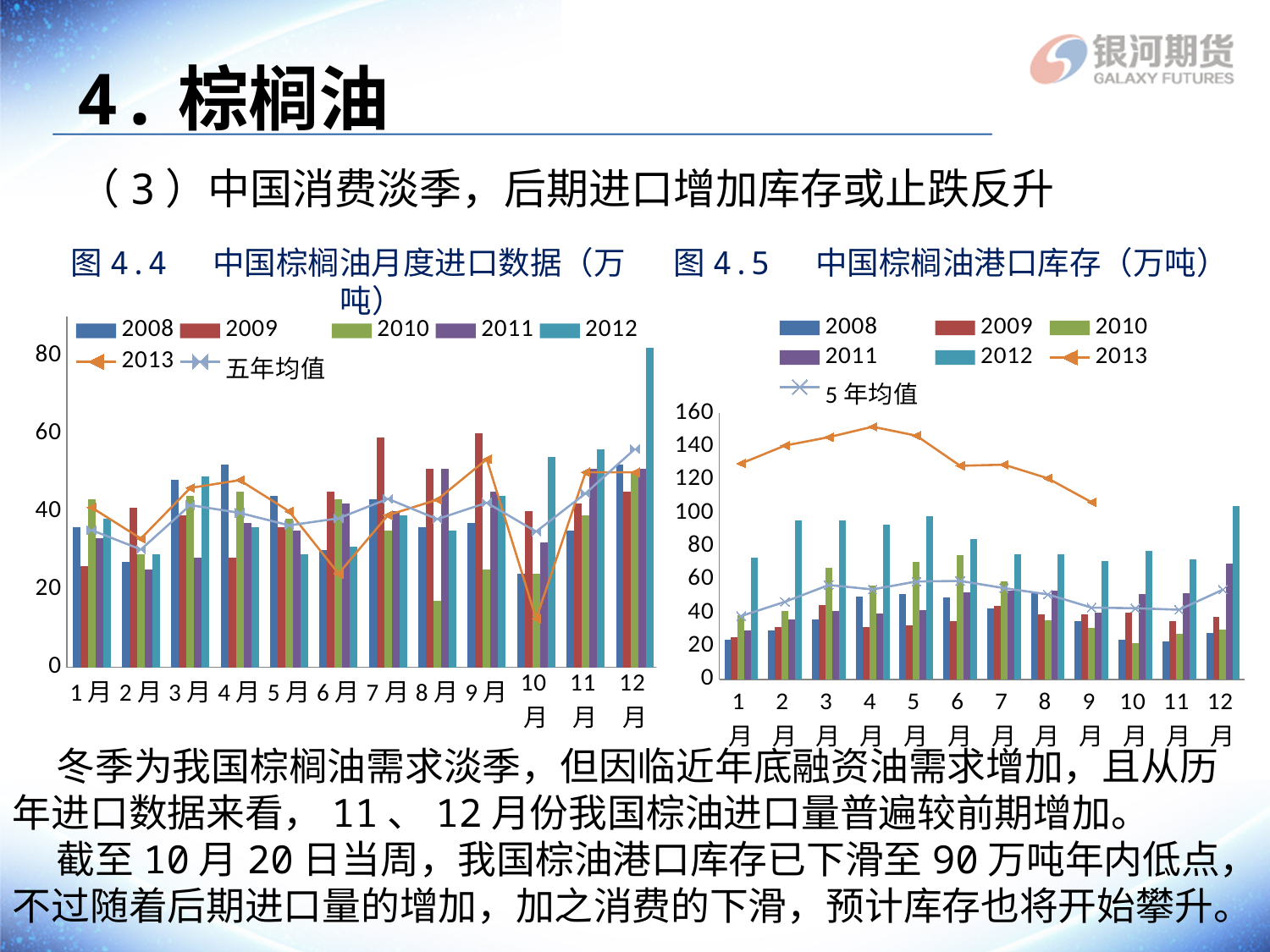
How many series does the legend of 图4.4 中国棕榈油月度进口数据 list? 7 In 图4.4 中国棕榈油月度进口数据, in which month is the 2013 value lowest? 10月 In 图4.5 中国棕榈油港口库存, is the 2012 value for 12月 greater or less than 80? greater In 图4.5 中国棕榈油港口库存, does the 2013 line rise or fall from 4月 to 9月? fall In 图4.5 中国棕榈油港口库存, in which month is the 2013 value highest? 4月 In 图4.4 中国棕榈油月度进口数据, which is larger: the 2012 value for 1月 or the 2012 value for 12月? 12月 How many months are shown on the x axis of 图4.4 中国棕榈油月度进口数据? 12 In 图4.5 中国棕榈油港口库存, is the 2013 value for 4月 greater or less than 140? greater In 图4.4 中国棕榈油月度进口数据, is the 2013 value for 10月 greater or less than 20? less How many series does the legend of 图4.5 中国棕榈油港口库存 list? 7 What kind of chart is 图4.4 中国棕榈油月度进口数据? Bar chart (with line series)